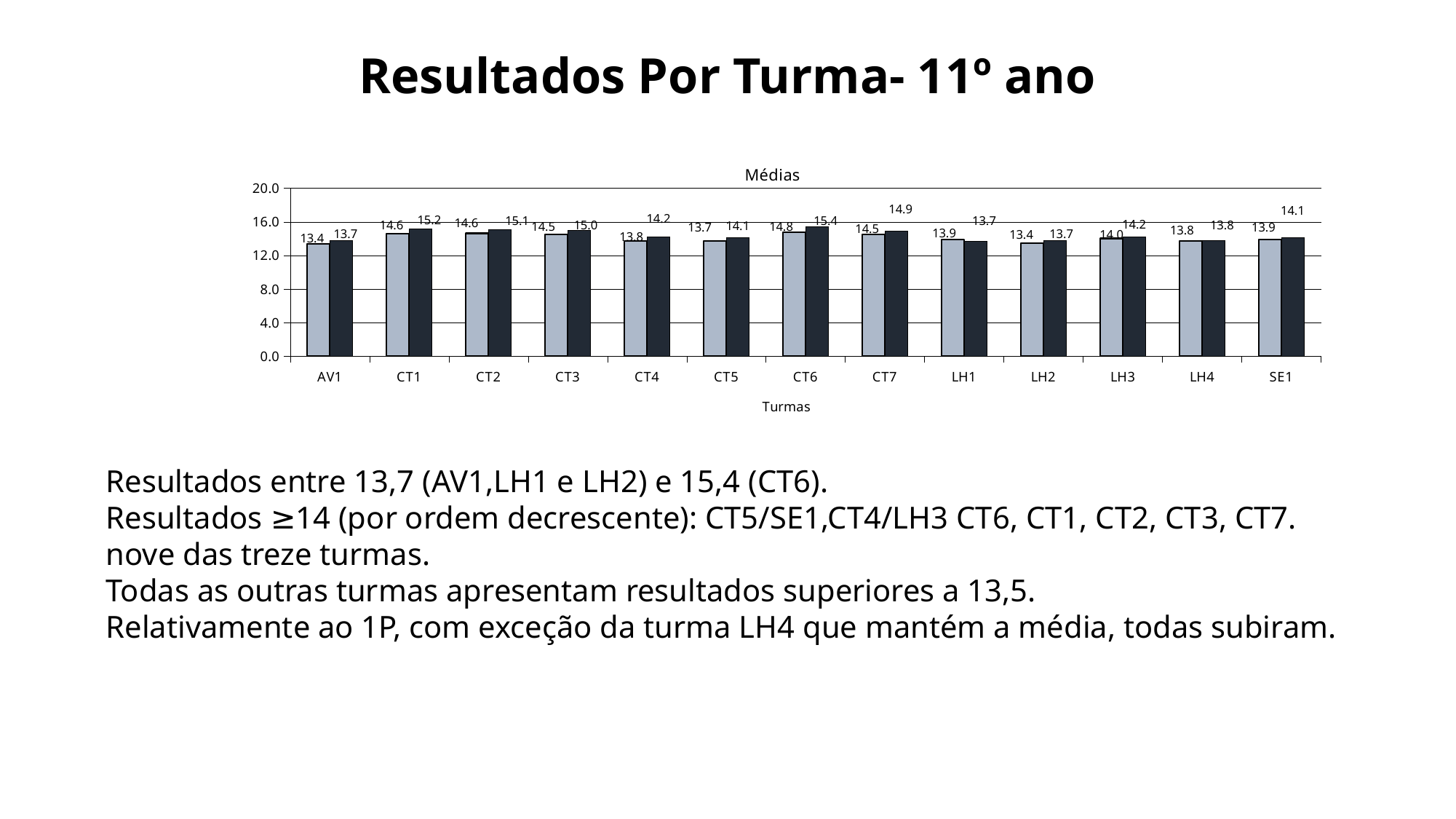
What is the value of the dark bar for LH4? 13.8 Is the dark bar value for CT7 greater or less than 12.0? greater What is the title of the chart? Médias What is the value of the light grey bar for CT4? 13.8 What is the difference between the dark bar and the light grey bar for CT1? 0.6 What is the value of the dark bar for CT6? 15.4 What type of chart is shown on the slide? bar chart How many turmas (categories) are shown on the x axis of the chart? 13 Which turma has the highest dark bar value? CT6 What is the value of the light grey bar for AV1? 13.4 What is the label of the x axis of the chart? Turmas Which is larger for LH1: the light grey bar or the dark bar? the light grey bar